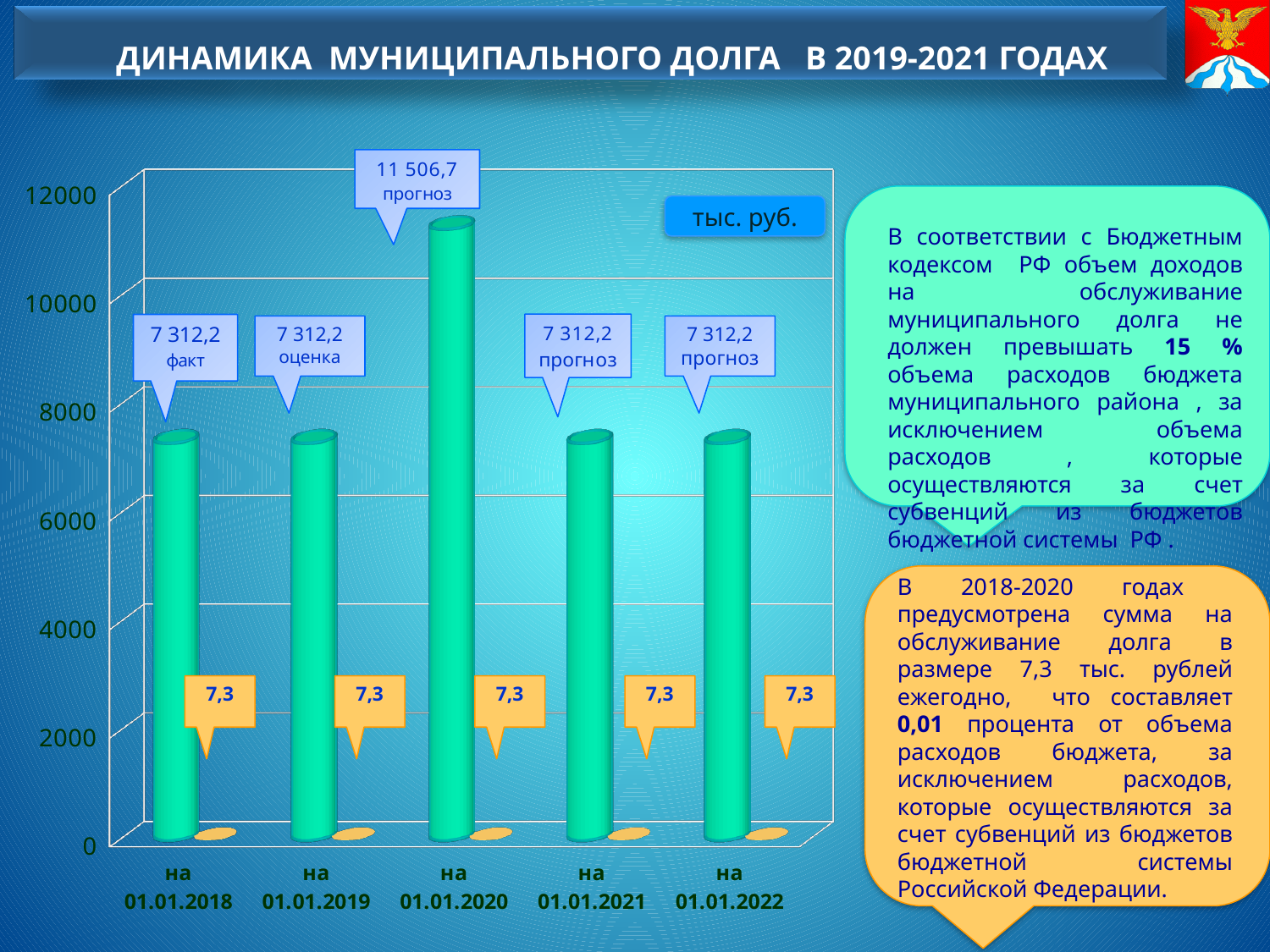
What is the value of municipal debt on 01.01.2018 according to the chart? 7 312,2 What unit of measurement is indicated for the chart values? тыс. руб. Is the value for 01.01.2021 greater or less than 8000? less On which date does the chart show the highest municipal debt? на 01.01.2020 What is the value of municipal debt on 01.01.2022 according to the chart? 7 312,2 What is the value of municipal debt on 01.01.2020 according to the chart? 11 506,7 What type of chart is shown on the slide? bar chart How many dates (categories) are shown on the x axis of the chart? 5 What label is attached to the value 7 312,2 for 01.01.2018? факт Is the value for 01.01.2020 greater or less than 10000? greater What is the difference between the municipal debt on 01.01.2020 and on 01.01.2019? 4 194,5 Which is larger: the municipal debt on 01.01.2020 or on 01.01.2021? 01.01.2020